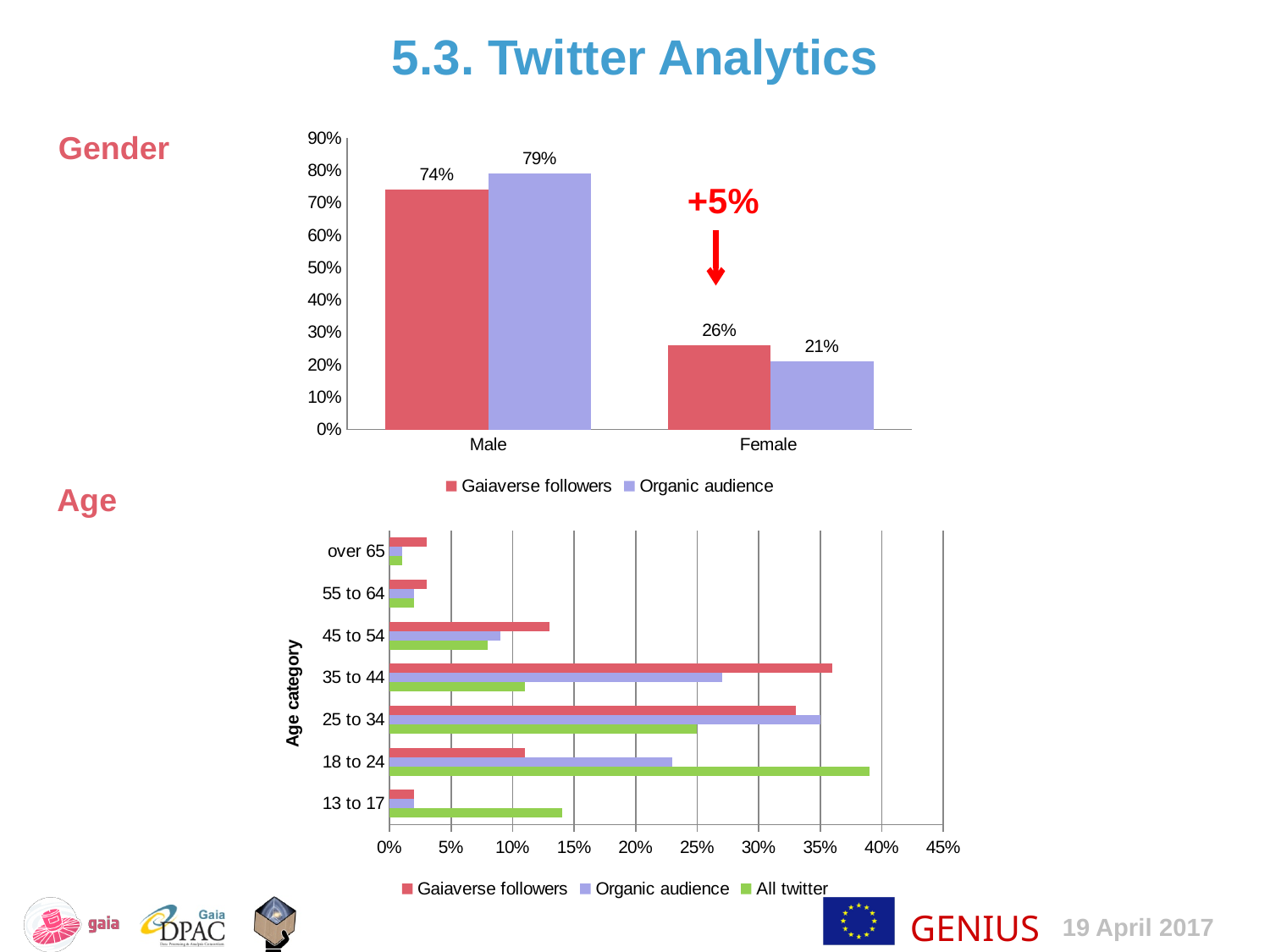
In the Gender chart, what is the value for Organic audience for Female? 21% In the Gender chart, how many series does the legend list? 2 What kind of chart is the Age chart? Bar chart In the Age chart, which age category has the highest All twitter value? 18 to 24 In the Age chart, which series is shown in green in the legend? All twitter In the Age chart, how many series does the legend list? 3 In the Age chart, is the All twitter value for 45 to 54 greater or less than 10%? less In the Age chart, how many age categories are shown? 7 In the Age chart, is the Gaiaverse followers value for 35 to 44 greater or less than 30%? greater In the Gender chart, what is the value for Gaiaverse followers for Male? 74% In the Gender chart, what is the difference between the Organic audience and Gaiaverse followers values for Male? 5% In the Gender chart, which is larger for Female: Gaiaverse followers or Organic audience? Gaiaverse followers